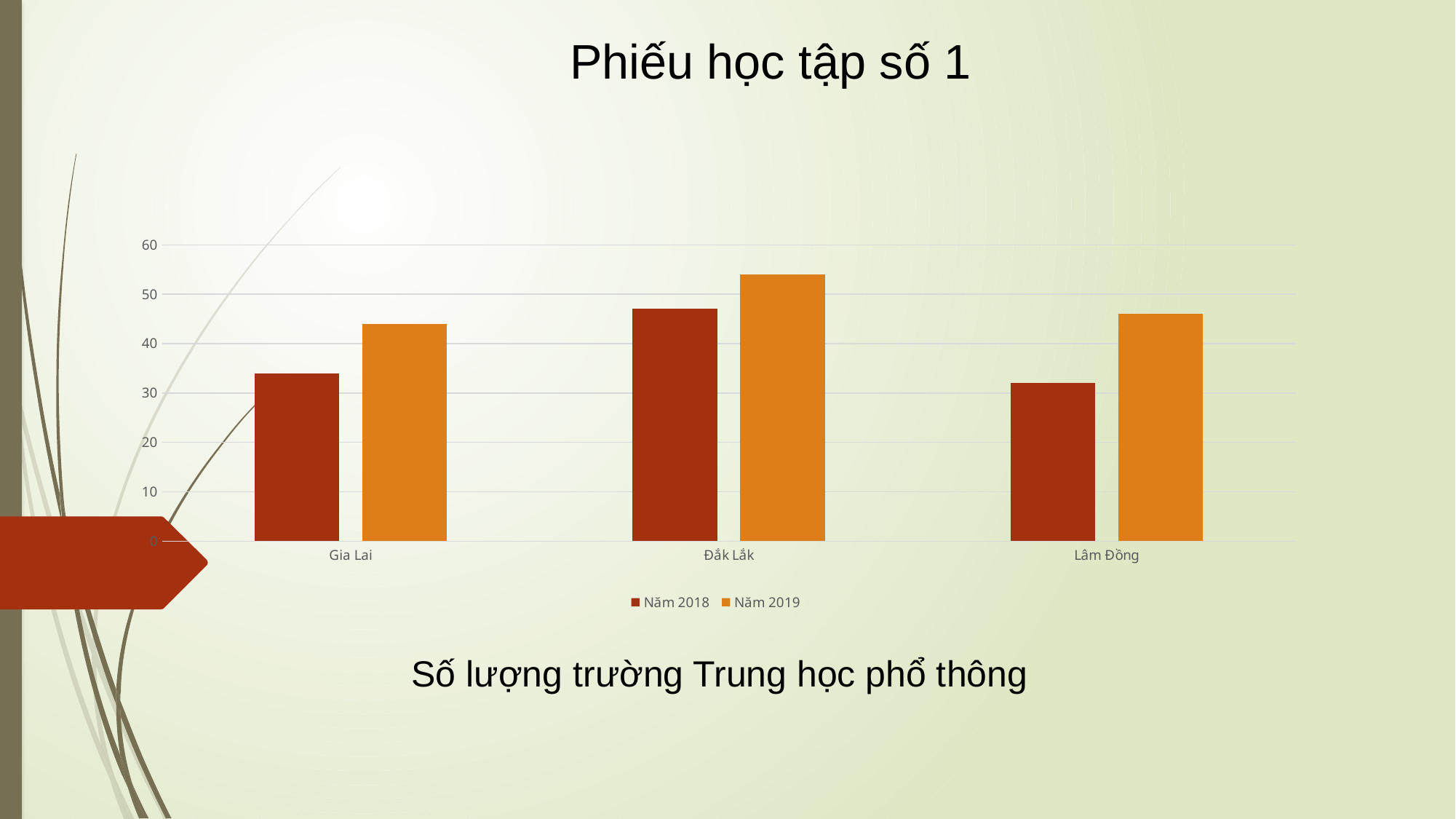
Is the value for Gia Lai in Năm 2019 greater or less than 50? less Which province has the highest value for Năm 2019? Đắk Lắk How many provinces (categories) are shown on the x axis? 3 For Gia Lai, which series has the larger value, Năm 2018 or Năm 2019? Năm 2019 Is the value for Đắk Lắk in Năm 2019 greater or less than 50? greater Which province has the highest value for Năm 2018? Đắk Lắk What kind of chart is shown on the slide? bar chart What is the caption text shown below the chart? Số lượng trường Trung học phổ thông How many series does the legend list? 2 Which is larger: the Năm 2019 value for Đắk Lắk or the Năm 2019 value for Gia Lai? Đắk Lắk Is the value for Lâm Đồng in Năm 2018 greater or less than 40? less